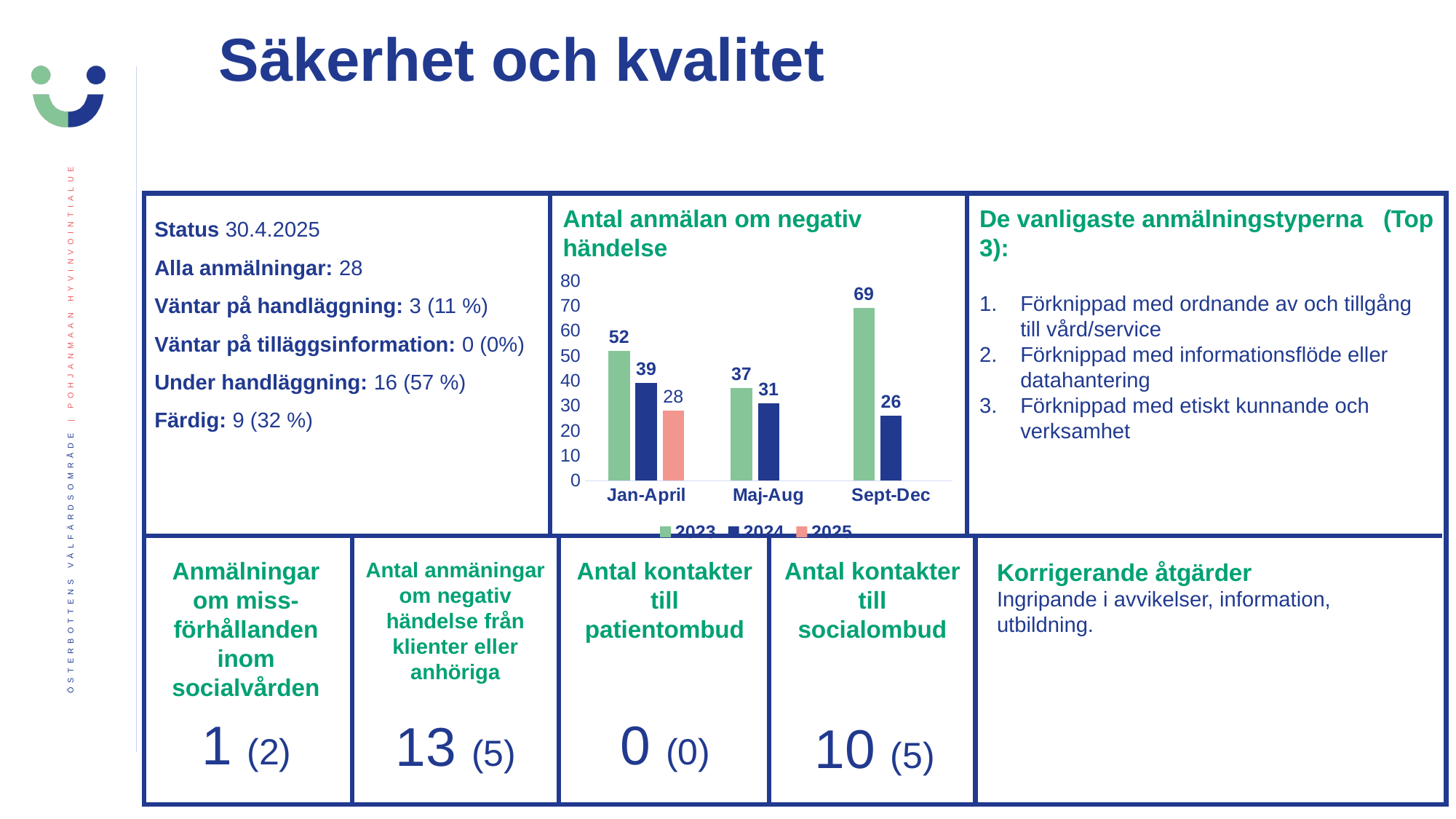
What is the value for 2024 in Maj-Aug? 31 How many periods are shown on the x axis? 3 What is the value for 2023 in Sept-Dec? 69 Do the 2024 values rise or fall from Jan-April to Sept-Dec? fall What is the difference between the 2023 and 2024 values in Sept-Dec? 43 Which is larger in Maj-Aug, the 2023 value or the 2024 value? 2023 Which period has the highest value for the 2023 series? Sept-Dec What kind of chart is shown? bar chart What is the value for 2025 in Jan-April? 28 How many series does the legend list? 3 Which period has the lowest value for the 2024 series? Sept-Dec What is the value for 2024 in Jan-April? 39